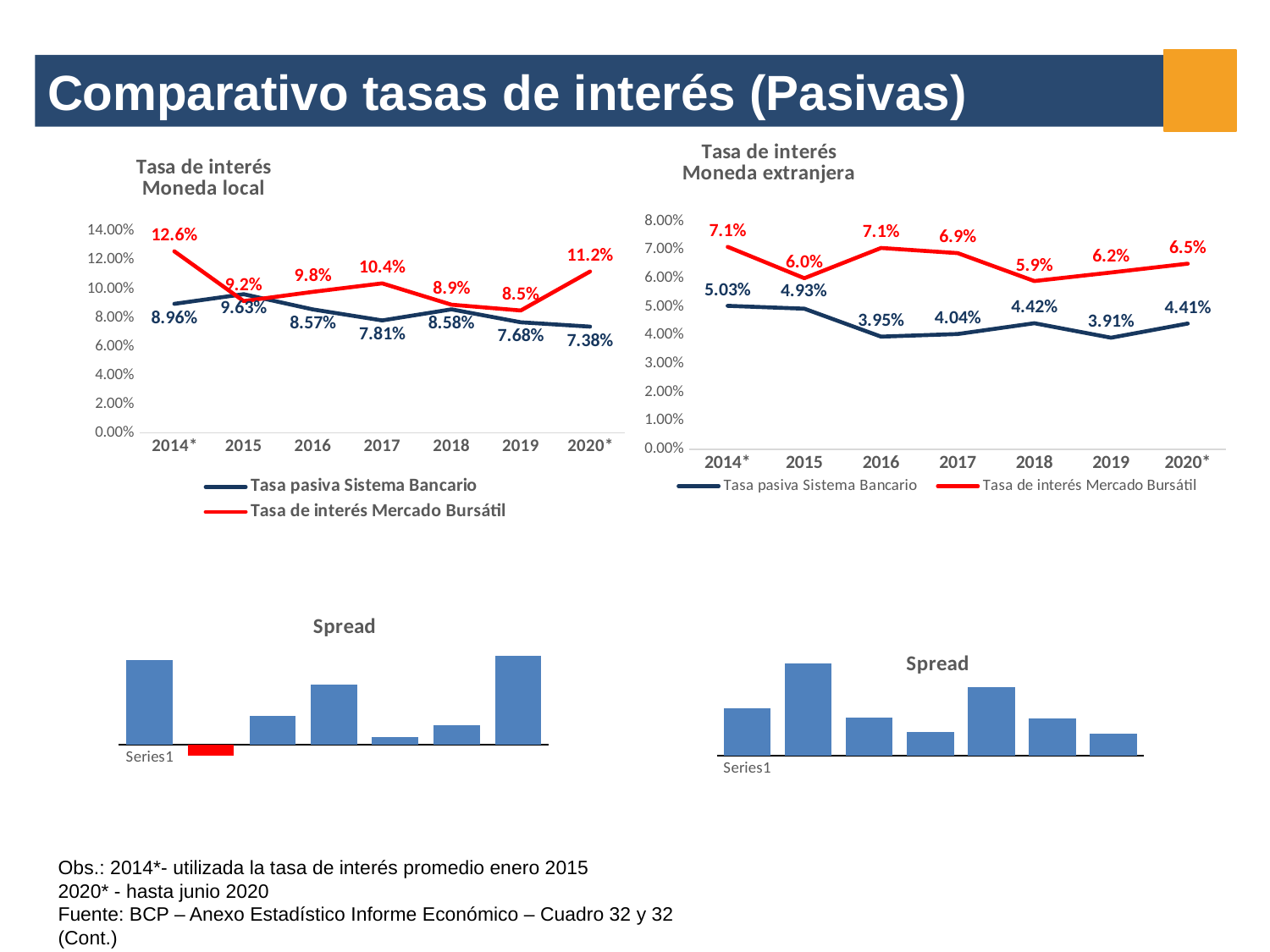
How many series does the legend of the 'Tasa de interés Moneda extranjera' chart list? 2 In the 'Tasa de interés Moneda extranjera' chart, which is larger in 2016: Tasa pasiva Sistema Bancario or Tasa de interés Mercado Bursátil? Tasa de interés Mercado Bursátil What kind of chart is the 'Spread' chart at the bottom left of the slide? Bar chart In the 'Tasa de interés Moneda local' chart, what is the value of Tasa pasiva Sistema Bancario in 2017? 7.81% In the 'Tasa de interés Moneda extranjera' chart, what is the value of Tasa pasiva Sistema Bancario in 2018? 4.42% In the 'Tasa de interés Moneda local' chart, what is the difference between Tasa pasiva Sistema Bancario in 2015 and in 2020*? 2.25% In the 'Tasa de interés Moneda extranjera' chart, what is the value of Tasa de interés Mercado Bursátil in 2019? 6.2% In the 'Spread' chart at the bottom right of the slide, how many bars are plotted? 7 In the 'Tasa de interés Moneda local' chart, what is the value of Tasa de interés Mercado Bursátil in 2020*? 11.2% In the 'Tasa de interés Moneda local' chart, in which year is Tasa pasiva Sistema Bancario lowest? 2020* In the 'Tasa de interés Moneda local' chart, in which year is Tasa de interés Mercado Bursátil highest? 2014* In the 'Tasa de interés Moneda extranjera' chart, in which year is Tasa de interés Mercado Bursátil lowest? 2018